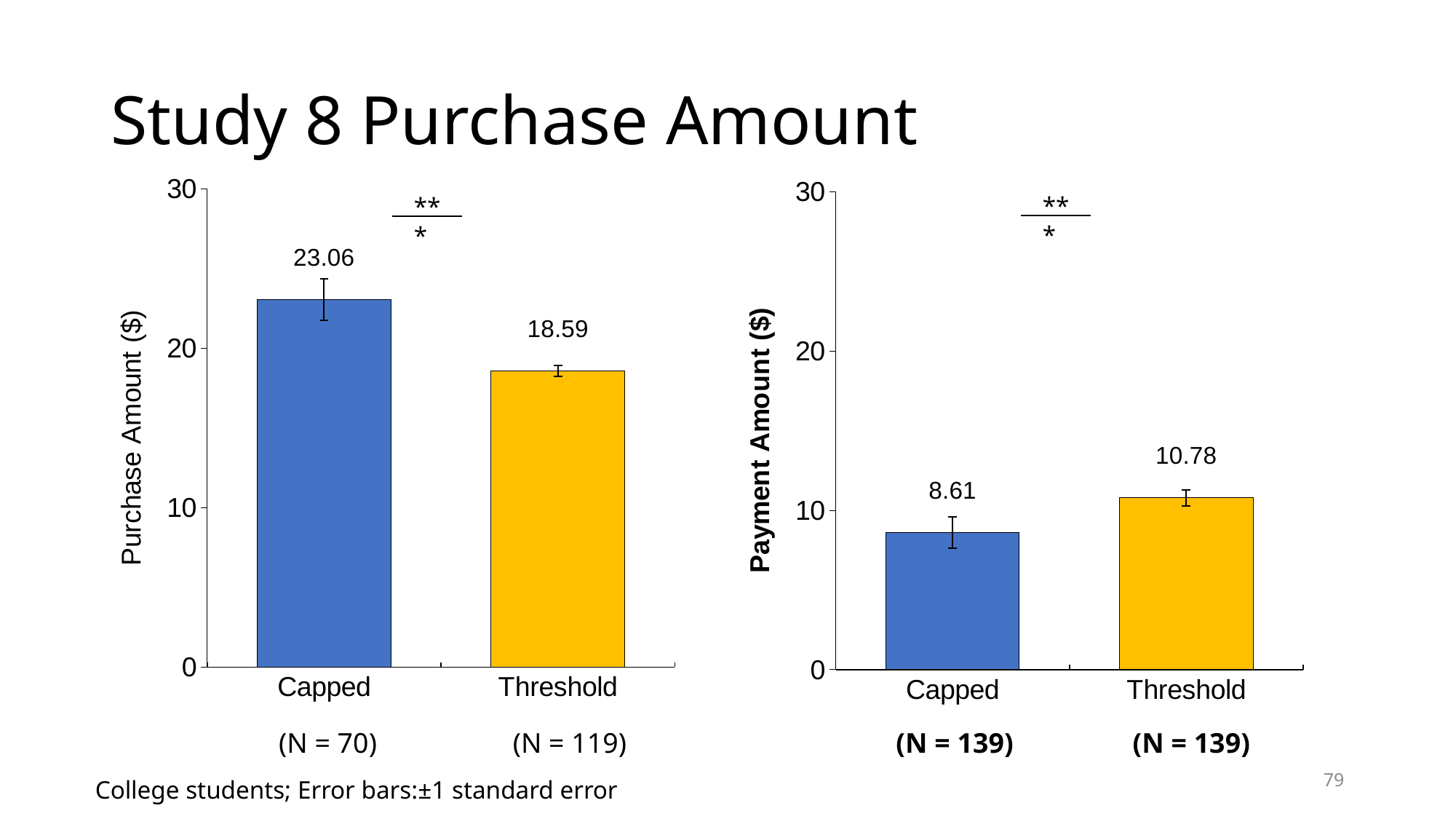
In the right chart (Payment Amount), is the value for Capped greater or less than 10? less In the left chart (Purchase Amount), what is the value for Threshold? 18.59 In the right chart (Payment Amount), which category has the lower value? Capped What is the y-axis label of the left chart? Purchase Amount ($) How many categories are shown in the left chart (Purchase Amount)? 2 In the left chart (Purchase Amount), what is the difference between the Capped and Threshold values? 4.47 What kind of chart is the right chart (Payment Amount)? bar chart In the right chart (Payment Amount), what is the difference between the Threshold and Capped values? 2.17 In the right chart (Payment Amount), what is the value for Capped? 8.61 In the right chart (Payment Amount), what is the value for Threshold? 10.78 In the left chart (Purchase Amount), which category has the higher value? Capped In the left chart (Purchase Amount), what is the value for Capped? 23.06